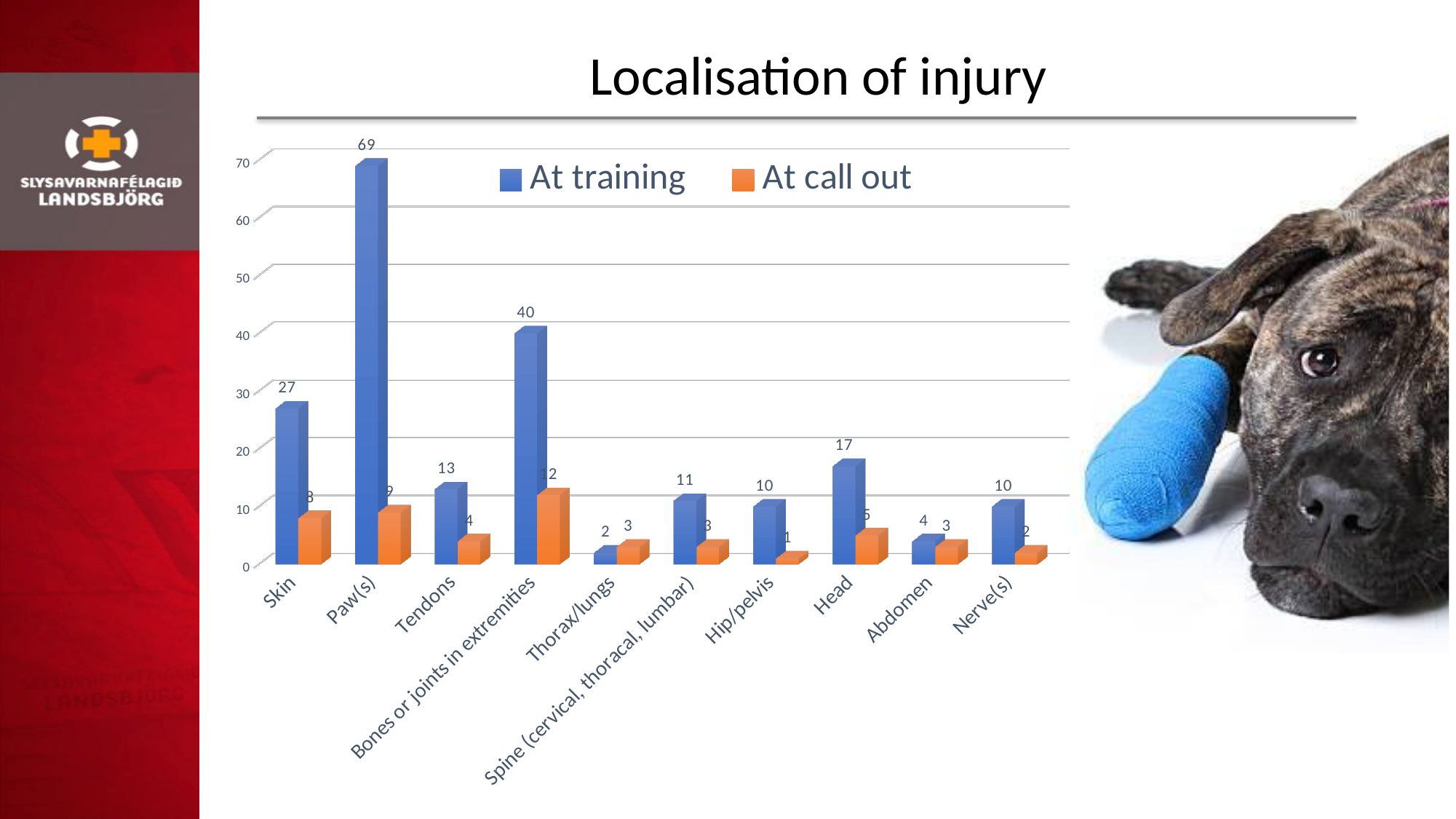
What is the 'At call out' value for Bones or joints in extremities? 12 What is the title of the chart? Localisation of injury Which category has the lowest 'At training' value? Thorax/lungs What is the 'At training' value for Head? 17 Which category has the highest 'At training' value? Paw(s) How many categories are shown on the x axis? 10 Which is larger for Thorax/lungs: the 'At training' value or the 'At call out' value? At call out How many series does the legend list? 2 Is the 'At training' value for Skin greater or less than 20? greater What kind of chart is shown on the slide? Bar chart What is the 'At training' value for Paw(s)? 69 What is the difference between the 'At training' values for Paw(s) and Bones or joints in extremities? 29